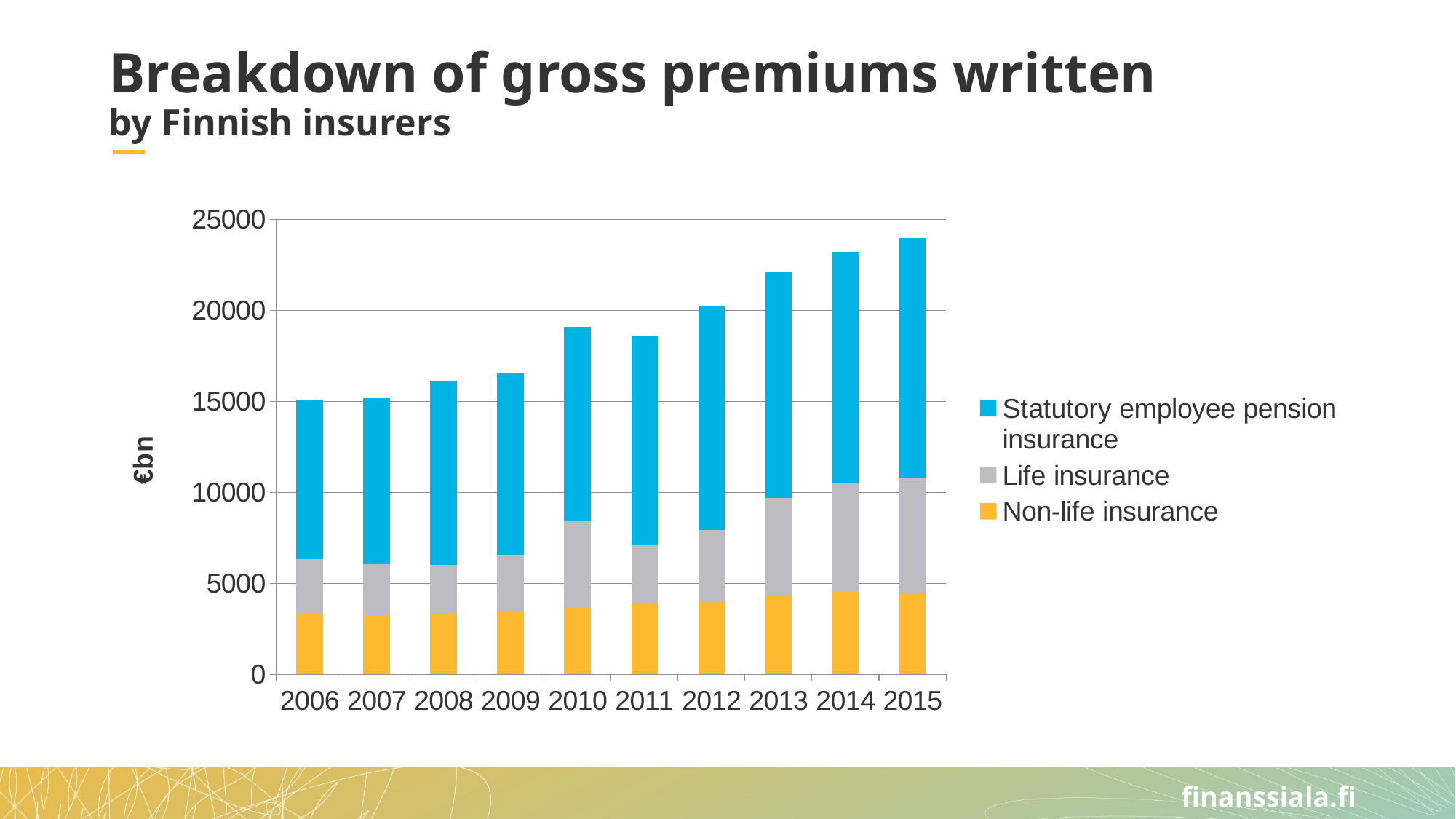
Do the total gross premiums written generally rise or fall from 2006 to 2015? Rise How many years are shown on the x axis of the chart? 10 How many series does the legend list? 3 What kind of chart is shown on the slide? Stacked bar chart Is the total value for 2015 greater or less than 20000? greater Is the total value for 2013 greater or less than 20000? greater Which year has the highest total gross premiums written? 2015 Is the Non-life insurance value for 2015 greater or less than 5000? less What unit is shown on the y-axis label of the chart? €bn Which series is shown in yellow in the chart? Non-life insurance Which year has the larger total gross premiums written, 2006 or 2015? 2015